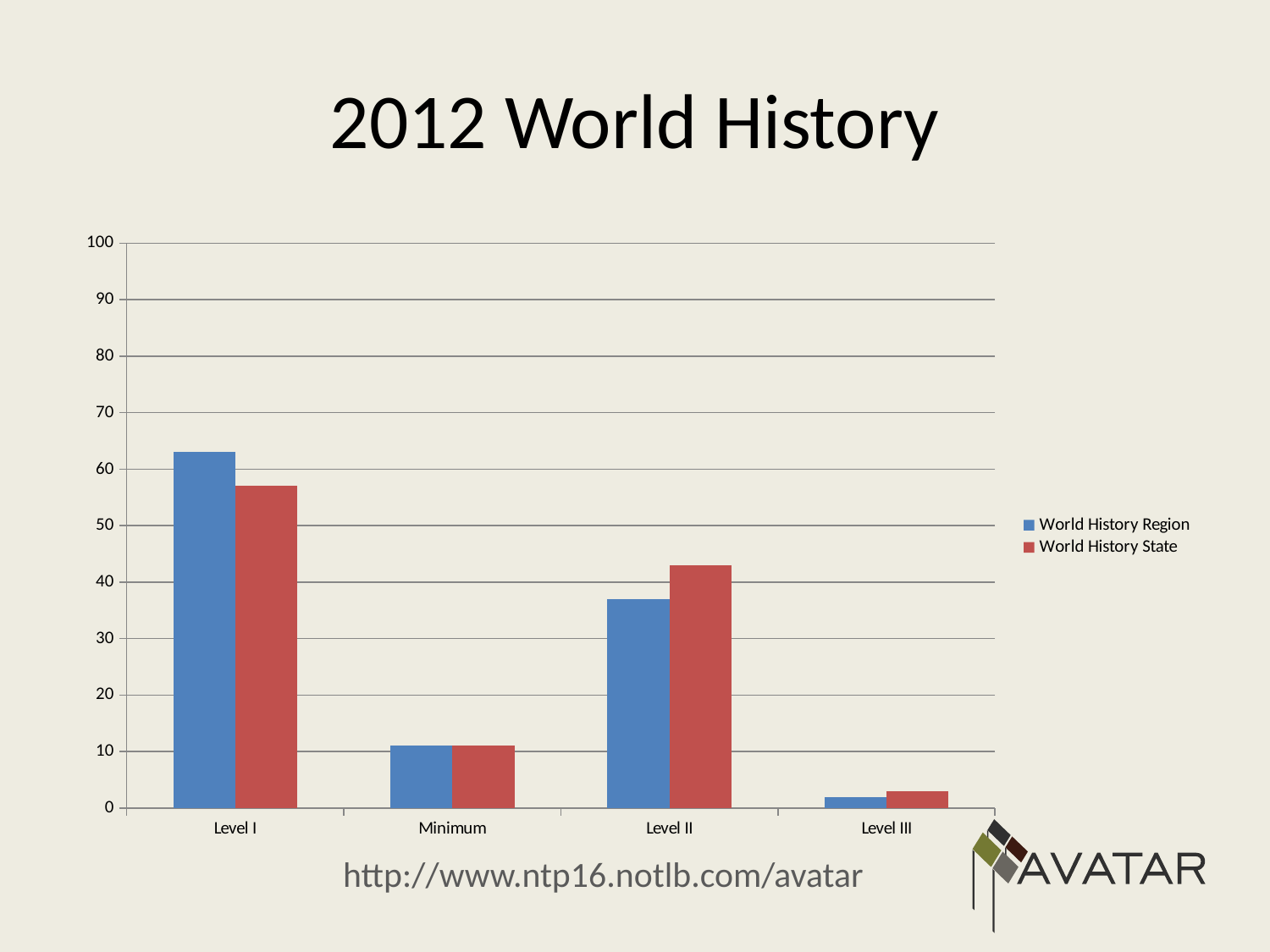
Which category has the lowest value for World History Region? Level III How many categories are shown on the x axis? 4 How many series does the legend list? 2 Is the World History State value for Level II greater or less than 40? greater Which category has the highest value for World History Region? Level I For Level I, which series has the larger value, World History Region or World History State? World History Region Is the World History Region value for Minimum greater or less than 20? less Is the World History Region value for Level I greater or less than 60? greater For Level II, which series has the larger value, World History Region or World History State? World History State What kind of chart is shown on the slide? bar chart What is the title of the chart? 2012 World History Which category has the lowest value for World History State? Level III